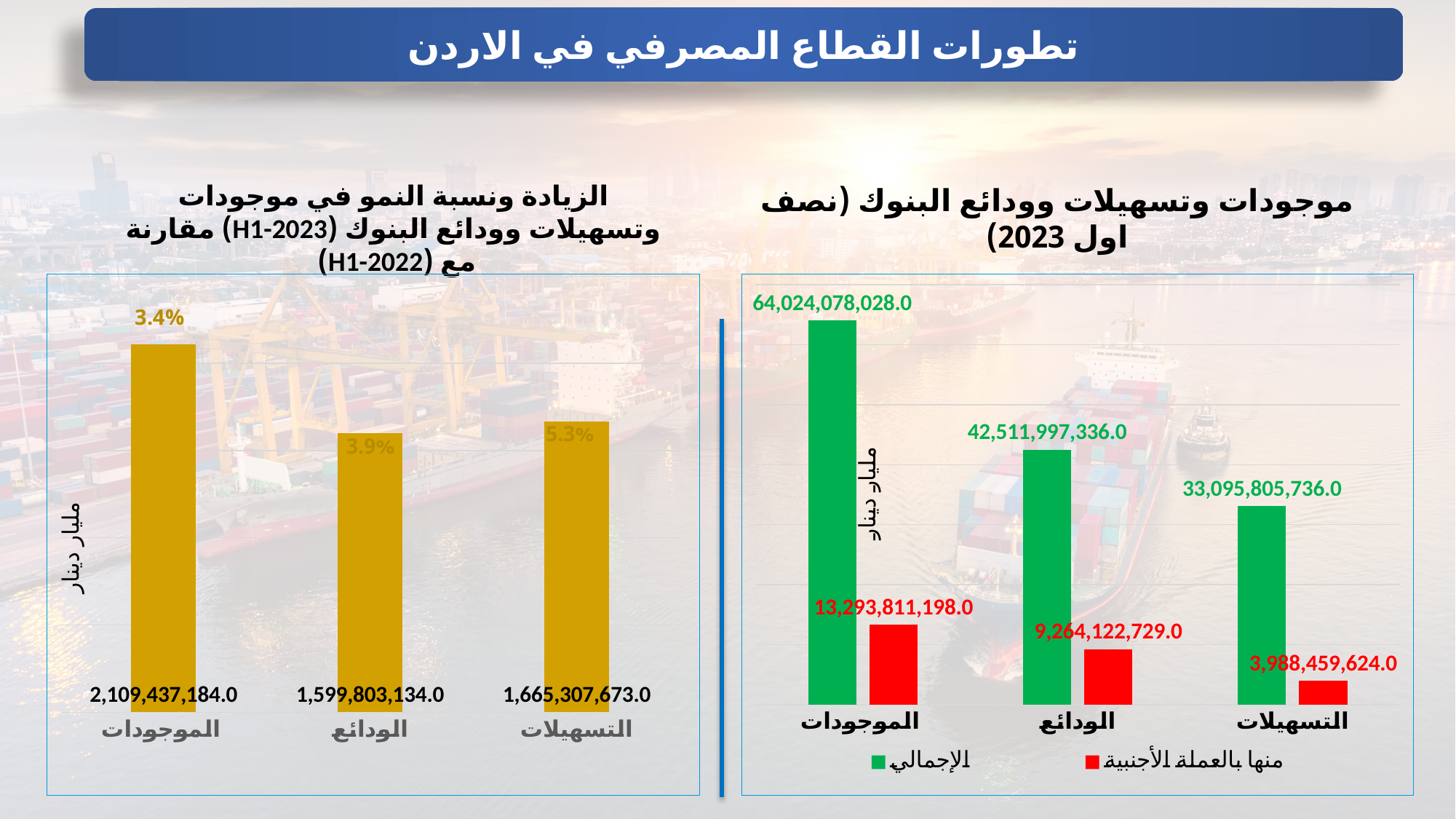
In the left chart (الزيادة ونسبة النمو), what is the value for الموجودات? 2,109,437,184.0 In the right chart, which series is shown in red? منها بالعملة الأجنبية What kind of chart is the left chart? bar chart In the left chart, what growth percentage is shown for التسهيلات? 5.3% In the right chart, what is the difference between the total values for الموجودات and الودائع? 21,512,080,692.0 In the right chart, what is the foreign-currency (منها بالعملة الأجنبية) value for التسهيلات? 3,988,459,624.0 In the left chart, what is the difference between the values for الموجودات and الودائع? 509,634,050.0 In the left chart, which category has the lowest value? الودائع In the right chart, what is the total (الإجمالي) value for الودائع? 42,511,997,336.0 In the right chart, which category has the lowest total (الإجمالي) value? التسهيلات In the right chart (موجودات وتسهيلات وودائع البنوك نصف اول 2023), what is the total (الإجمالي) value for الموجودات? 64,024,078,028.0 In the right chart, how many series does the legend list? 2